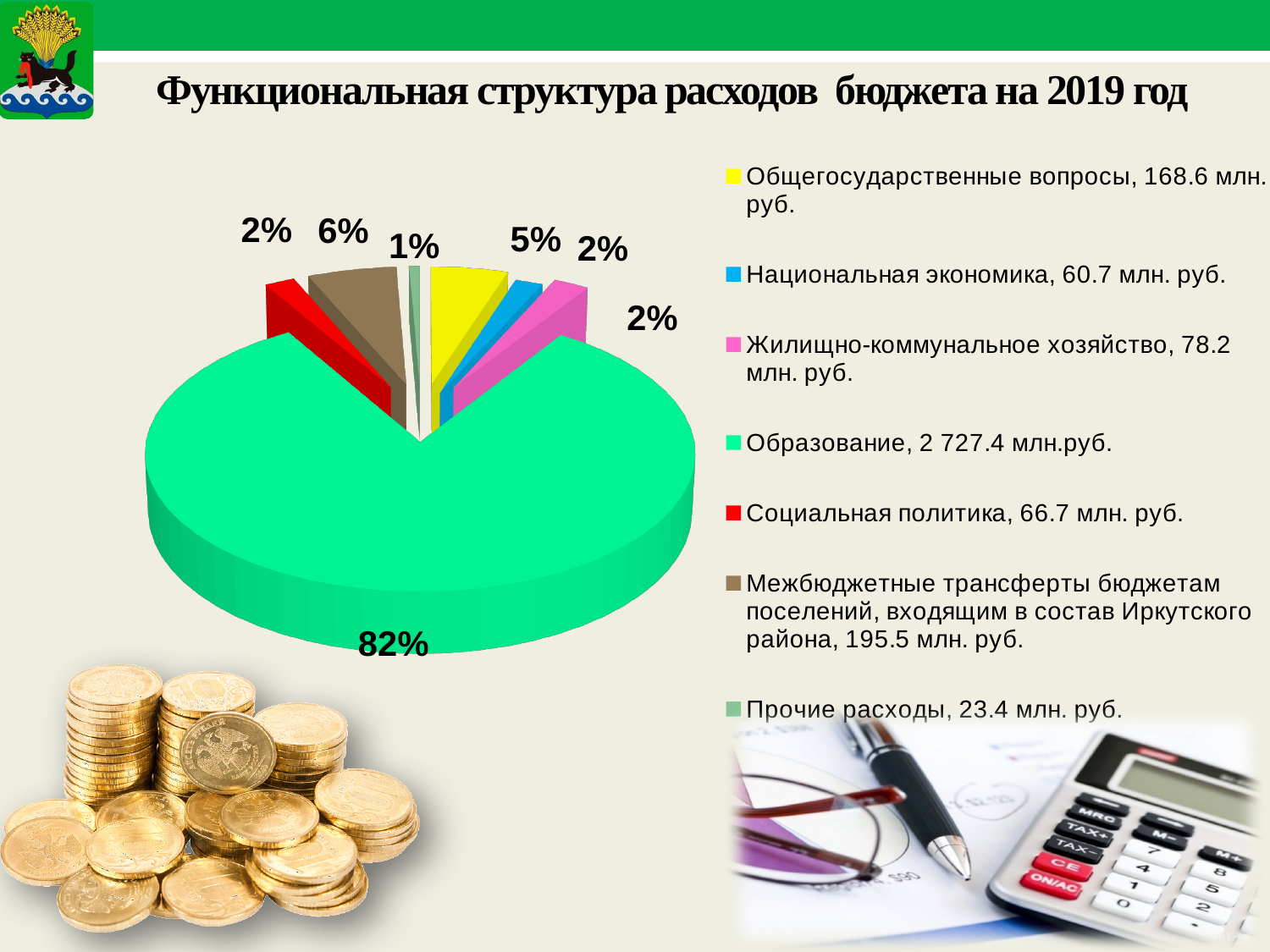
What share of the pie does Образование take? 82% Which category has the smallest slice of the pie? Прочие расходы What kind of chart is shown on the slide? pie chart Which is larger: the share for Межбюджетные трансферты бюджетам поселений or the share for Общегосударственные вопросы? Межбюджетные трансферты бюджетам поселений How many slices does the pie chart have? 7 What share of the pie does Общегосударственные вопросы take? 5% What is the title of the chart on the slide? Функциональная структура расходов бюджета на 2019 год What is the difference between the legend amounts for Жилищно-коммунальное хозяйство and Социальная политика, in млн. руб.? 11.5 What share of the pie does Межбюджетные трансферты бюджетам поселений take? 6% Which category has the largest slice of the pie? Образование According to the legend, what is the amount for Образование? 2 727.4 млн.руб. According to the legend, what is the amount for Национальная экономика? 60.7 млн. руб.